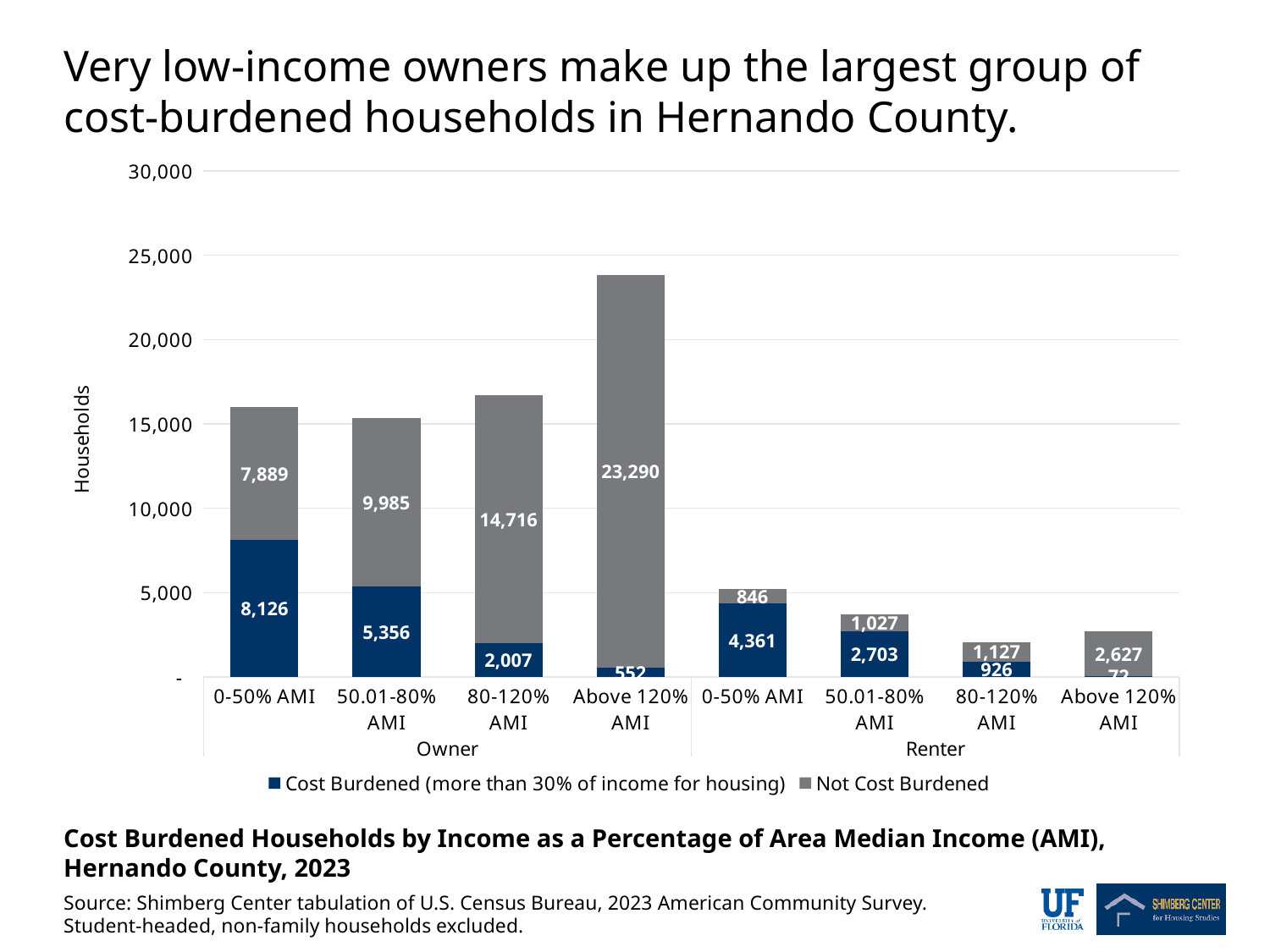
What is the number of not cost burdened owner households in the Above 120% AMI group? 23,290 What is the number of cost burdened owner households in the 0-50% AMI group? 8,126 For renter households in the 80-120% AMI group, which is larger: cost burdened or not cost burdened? Not Cost Burdened Among owner households, which income group has the smallest number of cost burdened households? Above 120% AMI What type of chart is shown on the slide? Stacked bar chart How many series does the legend list? 2 Is the total height of the Owner Above 120% AMI bar greater or less than 20,000? greater What is the total number of owner households in the 0-50% AMI group (cost burdened plus not cost burdened)? 16,015 What is the total number of renter households in the 50.01-80% AMI group (cost burdened plus not cost burdened)? 3,730 Which income group has the largest number of cost burdened households? Owner 0-50% AMI What is the number of cost burdened renter households in the 0-50% AMI group? 4,361 For owner households in the 0-50% AMI group, how many more are cost burdened than not cost burdened? 237